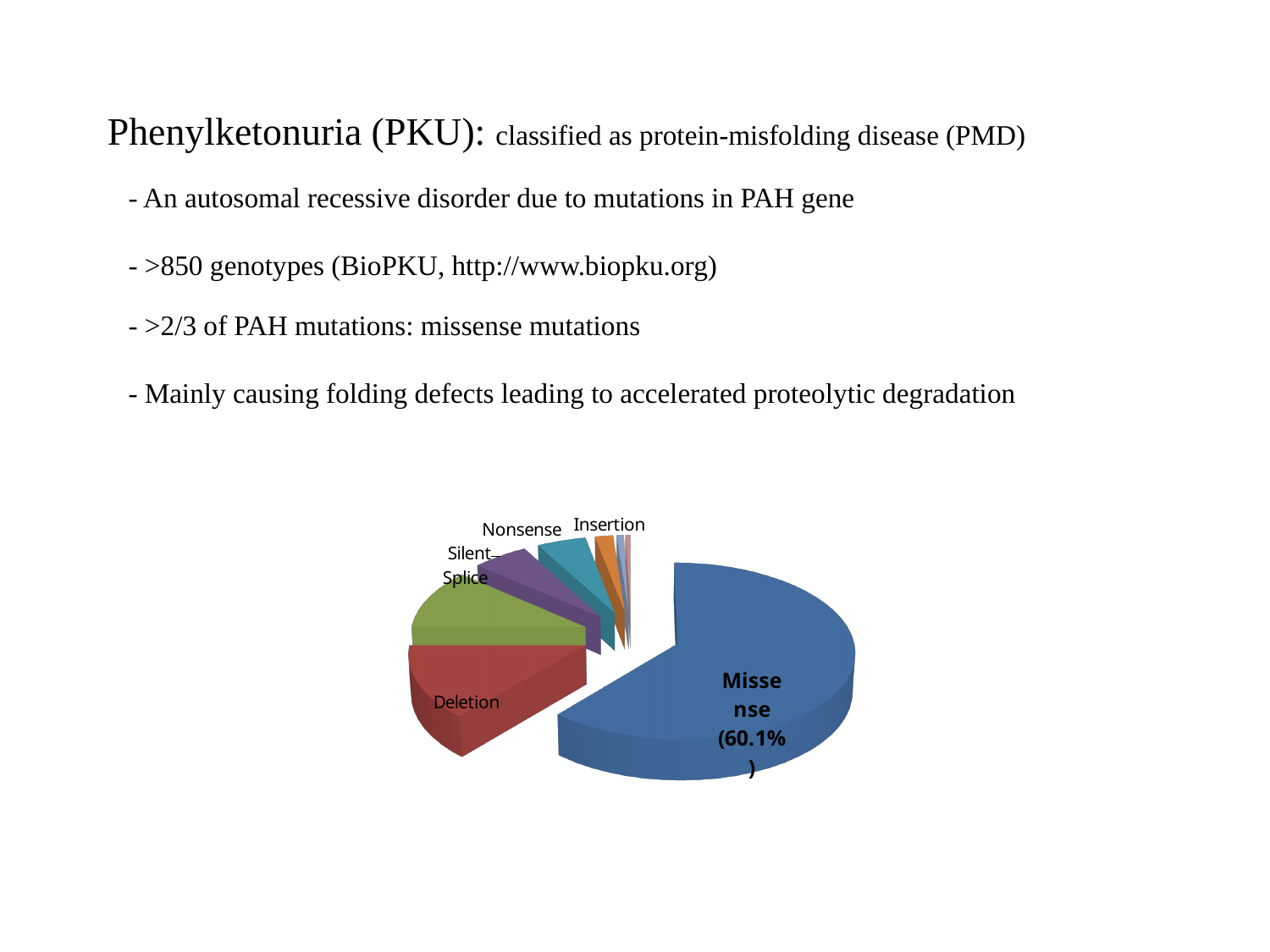
Which slice is larger, Splice or Silent? Splice What colour is the Deletion slice? red What kind of chart is shown on the slide? pie chart Which slice is larger, Missense or Deletion? Missense Which of the labelled slices is the smallest? Insertion Which slice is larger, Nonsense or Insertion? Nonsense Which slice of the pie chart is the largest? Missense What colour is the Missense slice? blue What share of the pie does the Missense slice represent? 60.1%